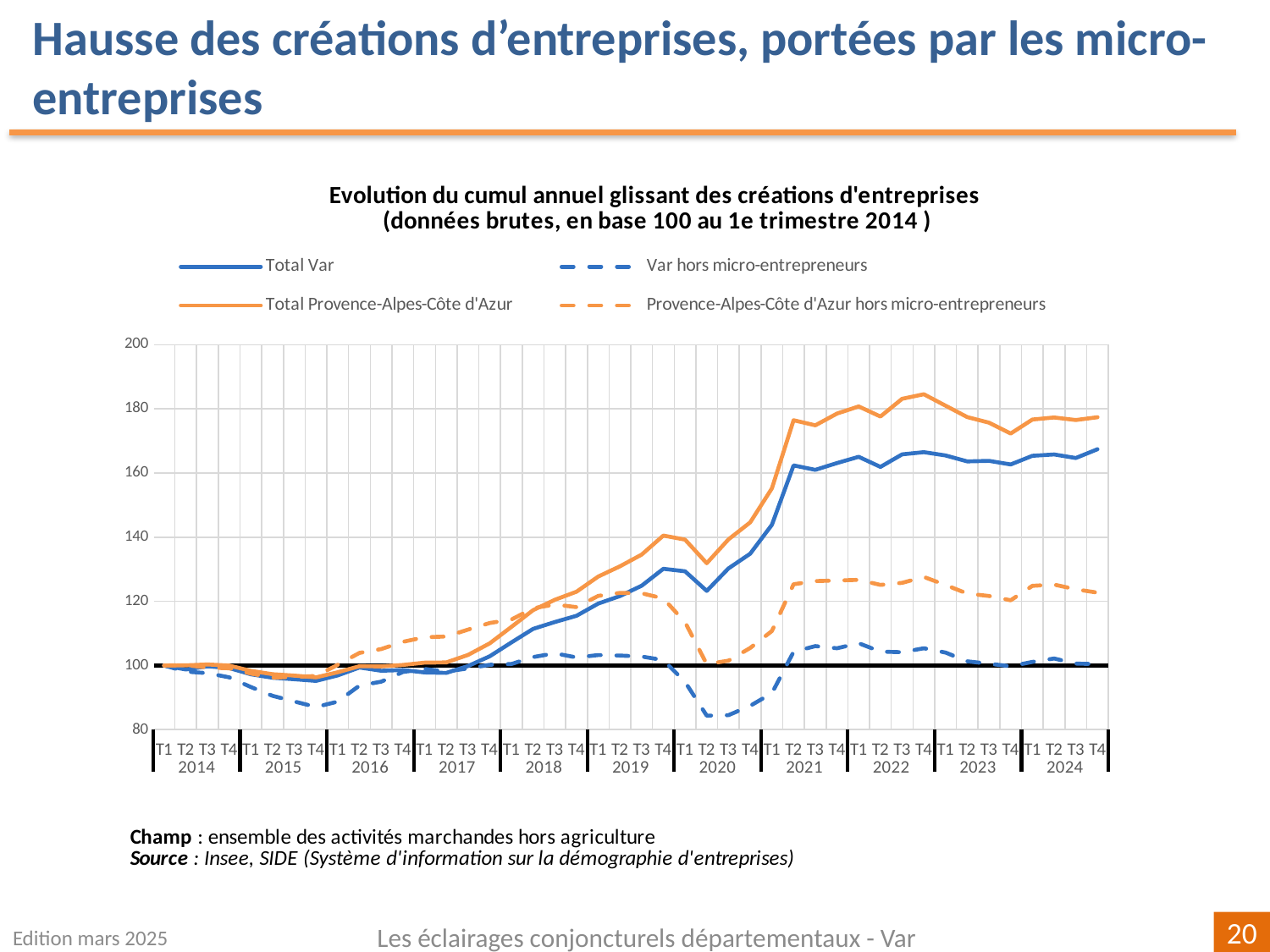
Is the value for Total Var at T4 2024 greater or less than 180? less At T4 2024, which is larger: Total Var or Total Provence-Alpes-Côte d'Azur? Total Provence-Alpes-Côte d'Azur Which series has the lowest value at T2 2020? Var hors micro-entrepreneurs How many series does the chart legend list? 4 Is the value for Total Provence-Alpes-Côte d'Azur at T4 2024 greater or less than 160? greater Which two series are drawn with dashed lines? Var hors micro-entrepreneurs and Provence-Alpes-Côte d'Azur hors micro-entrepreneurs What is the value of every series at T1 2014, the base period? 100 Is the value for Provence-Alpes-Côte d'Azur hors micro-entrepreneurs at T4 2024 greater or less than 140? less Which series has the highest value at T4 2022? Total Provence-Alpes-Côte d'Azur What kind of chart is shown on the slide? line chart Overall, does the Total Var series rise or fall between 2014 and 2024? rise